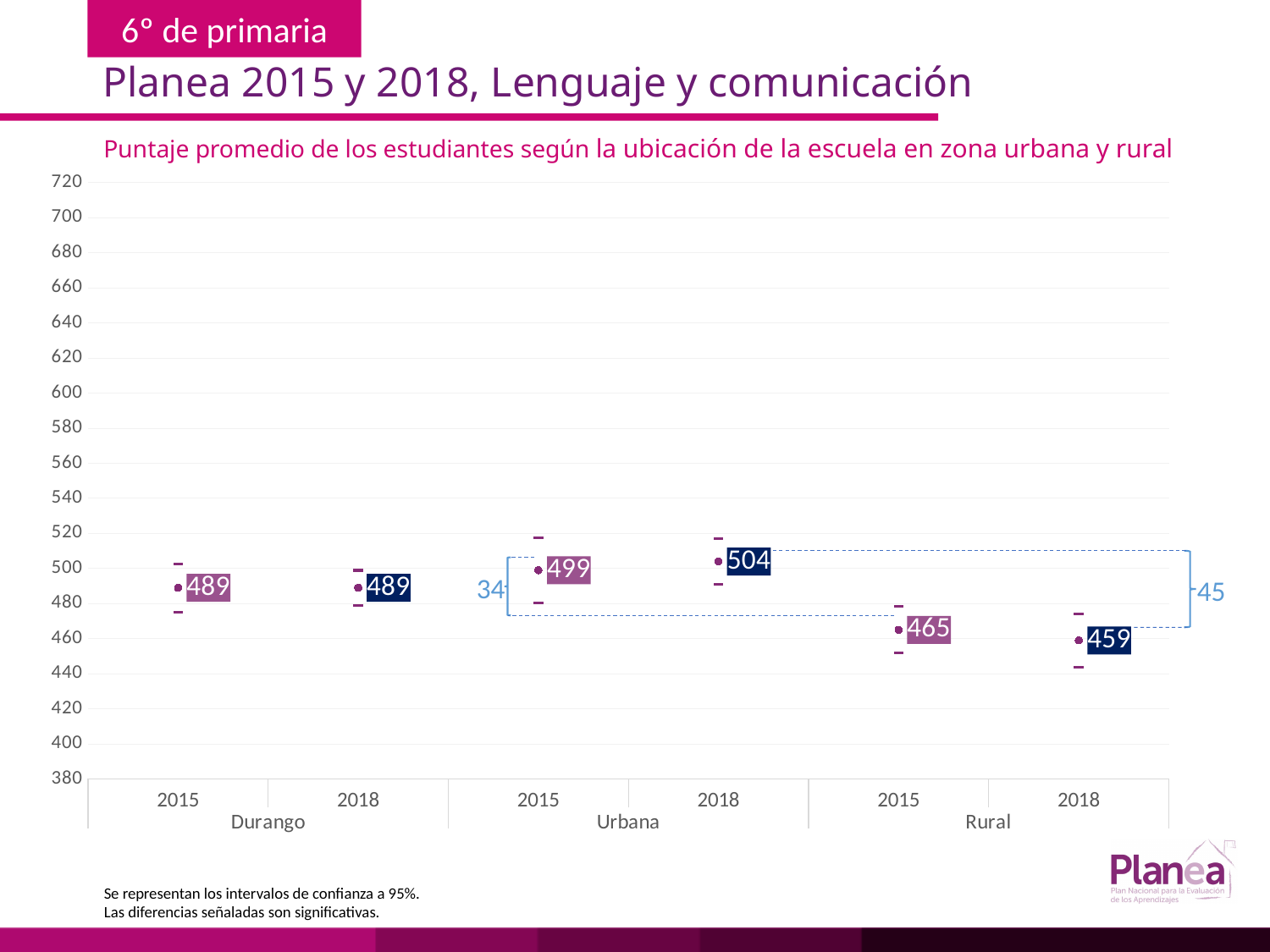
Did the Durango average score change between 2015 and 2018? No, it stayed at 489 What is the average score for Rural in 2015? 465 What confidence level do the intervals shown on the chart represent? 95% Which group and year has the highest average score? Urbana 2018 How many data points are plotted on the chart? 6 What is the difference between the Urbana and Rural scores in 2018? 45 What is the difference between the Urbana and Rural scores in 2015? 34 Is the Urbana score in 2018 greater or less than 500? greater Which is larger, the Rural score in 2015 or the Rural score in 2018? Rural 2015 Which group and year has the lowest average score? Rural 2018 What is the average score for Durango in 2018? 489 What is the average score for Urbana in 2018? 504